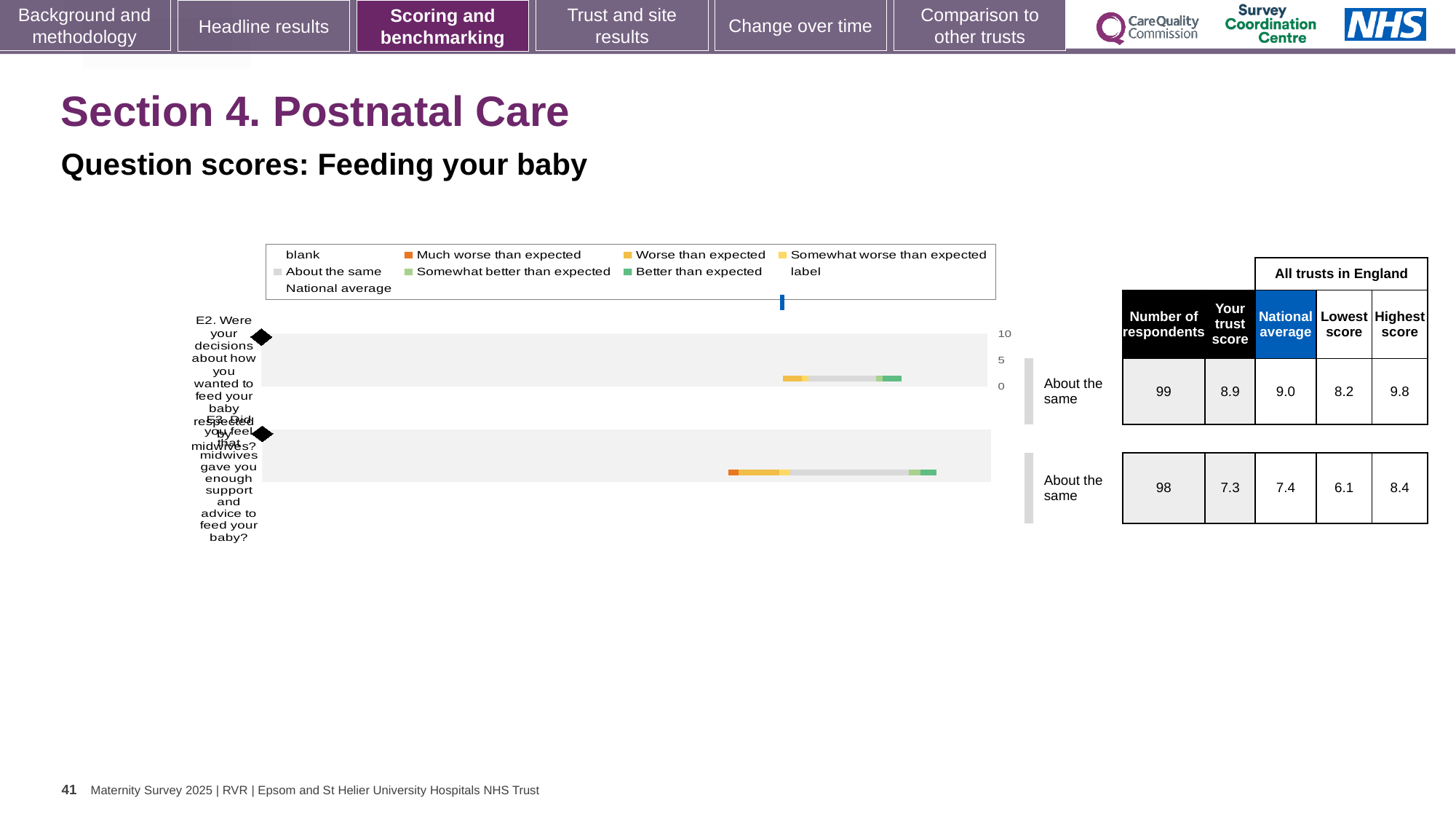
What is the difference between the highest and lowest scores for question E2? 1.6 What is the difference between the national average and the trust score for question E3? 0.1 What is the trust score for question E2 about decisions on how to feed your baby being respected by midwives? 8.9 What is the lowest score among all trusts in England for question E3? 6.1 Which question has the higher trust score, E2 or E3? E2 For question E2, which is larger: the trust score or the national average? National average What is the national average for question E3 about midwives giving enough support and advice to feed your baby? 7.4 What benchmark category is shown for question E3? About the same How many respondents answered question E2? 99 How many questions are plotted in the Feeding your baby chart? 2 What kind of chart is used to show the question scores for Feeding your baby? Horizontal bar chart What is the highest score among all trusts in England for question E3? 8.4